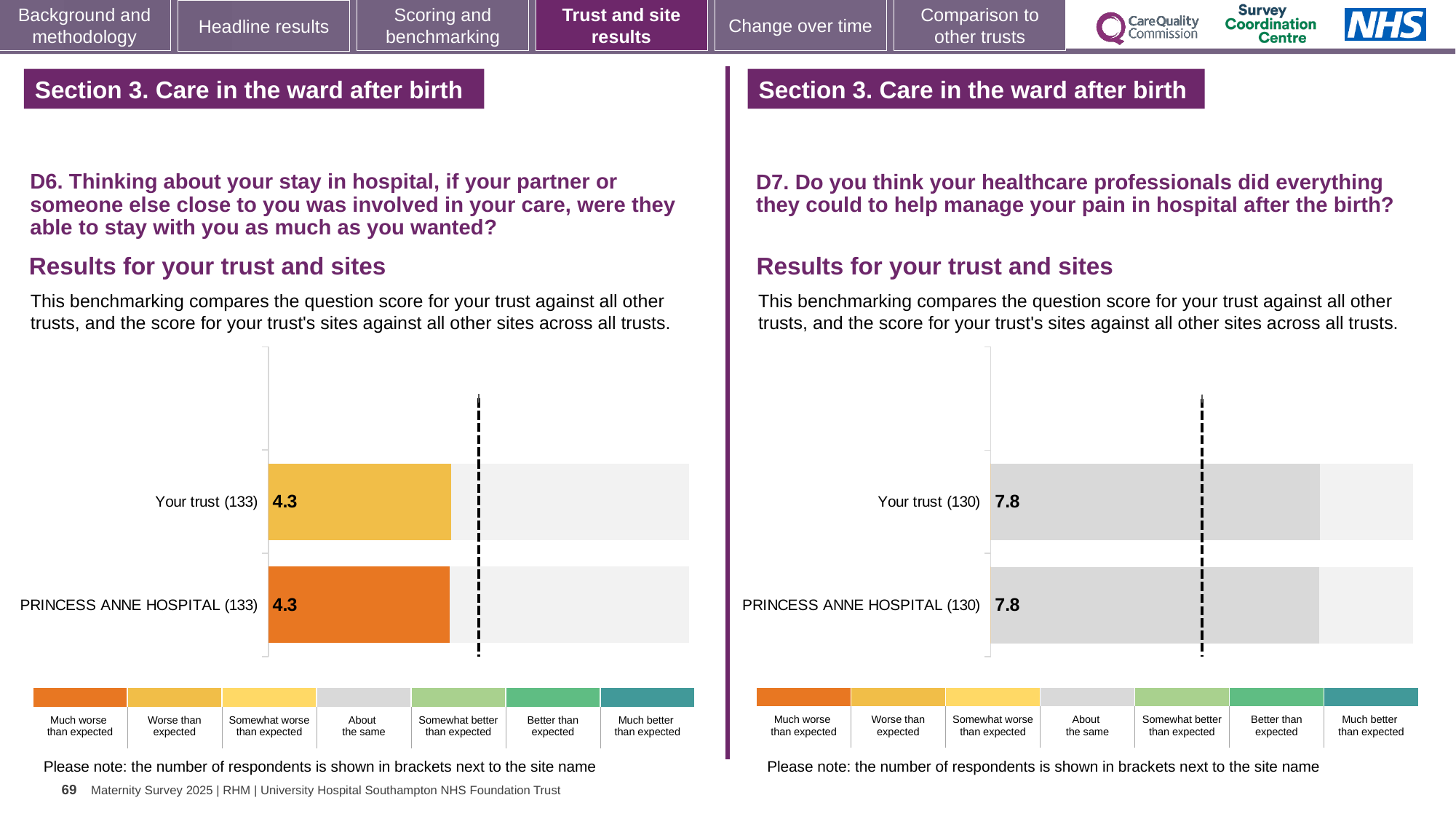
How many bars are plotted in the D7 chart on the right? 2 In the D6 chart on the left, which benchmark category does the colour of the PRINCESS ANNE HOSPITAL bar correspond to in the key? Much worse than expected In the D7 chart on the right, what is the score for Your trust? 7.8 How many bars are plotted in the D6 chart on the left? 2 In the D7 chart on the right, how many respondents are shown in brackets for PRINCESS ANNE HOSPITAL? 130 In the D6 chart on the left, what is the score for PRINCESS ANNE HOSPITAL? 4.3 In the D6 chart on the left, what is the score for Your trust? 4.3 In the D6 chart on the left, how many respondents are shown in brackets for Your trust? 133 In the D7 chart on the right, what is the score for PRINCESS ANNE HOSPITAL? 7.8 In the D6 chart on the left, what is the difference between the score for Your trust and the score for PRINCESS ANNE HOSPITAL? 0.0 In the D7 chart on the right, what is the difference between the score for Your trust and the score for PRINCESS ANNE HOSPITAL? 0.0 What kind of chart is used for the D6 results on the left? Bar chart